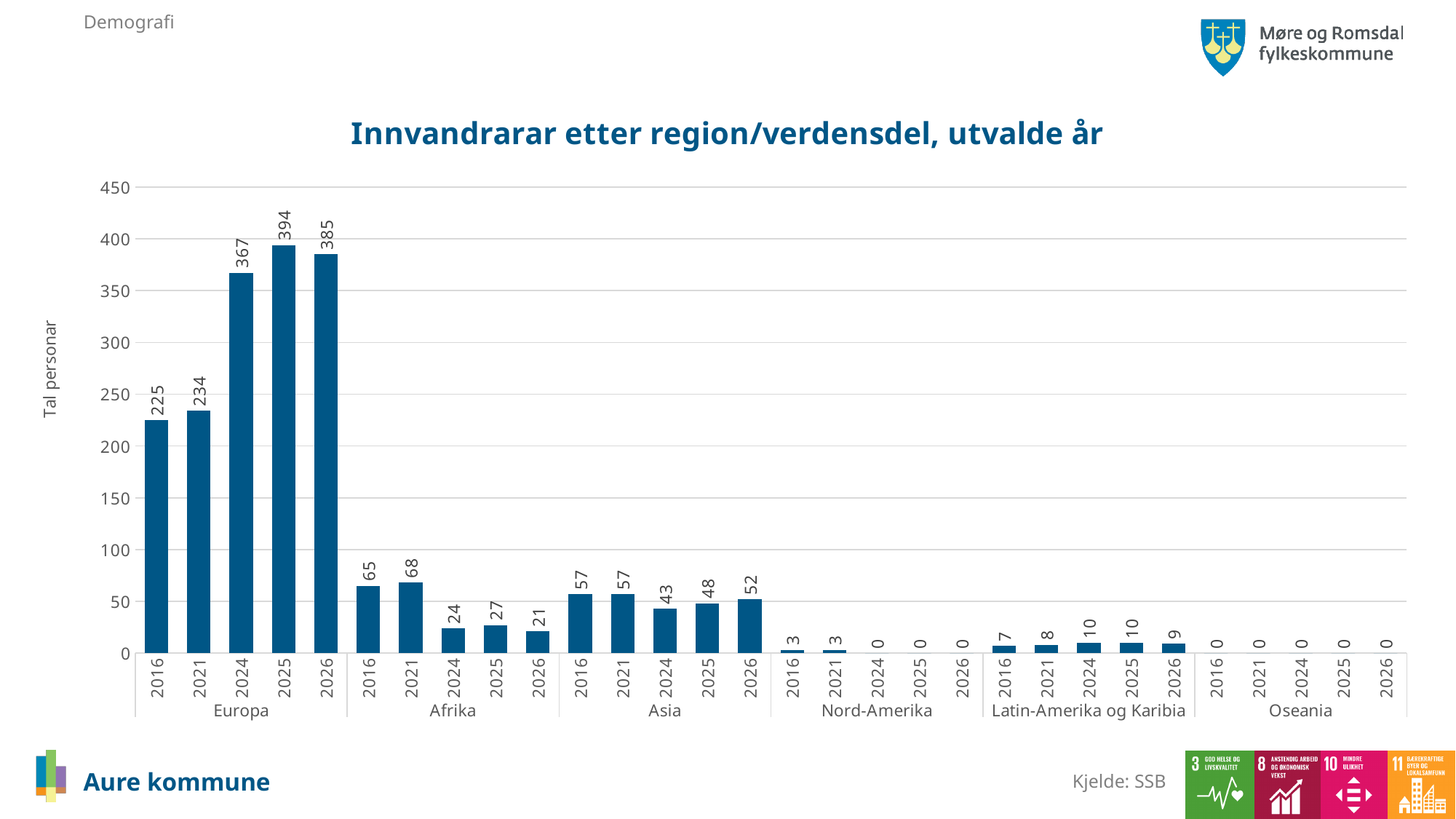
What is the difference between the Europa values for 2025 and 2016? 169 Which year has the highest value for Europa? 2025 Is the value for Europa in 2024 greater or less than 350? greater What is the title of the chart? Innvandrarar etter region/verdensdel, utvalde år What is the value for Afrika in 2021? 68 Which year has the lowest value for Afrika? 2026 What is the value for Europa in 2025? 394 How many regions are shown on the x axis? 6 What is the value for Asia in 2024? 43 Which is larger: Asia in 2016 or Afrika in 2016? Afrika in 2016 What is the value for Latin-Amerika og Karibia in 2026? 9 What kind of chart is this? Bar chart